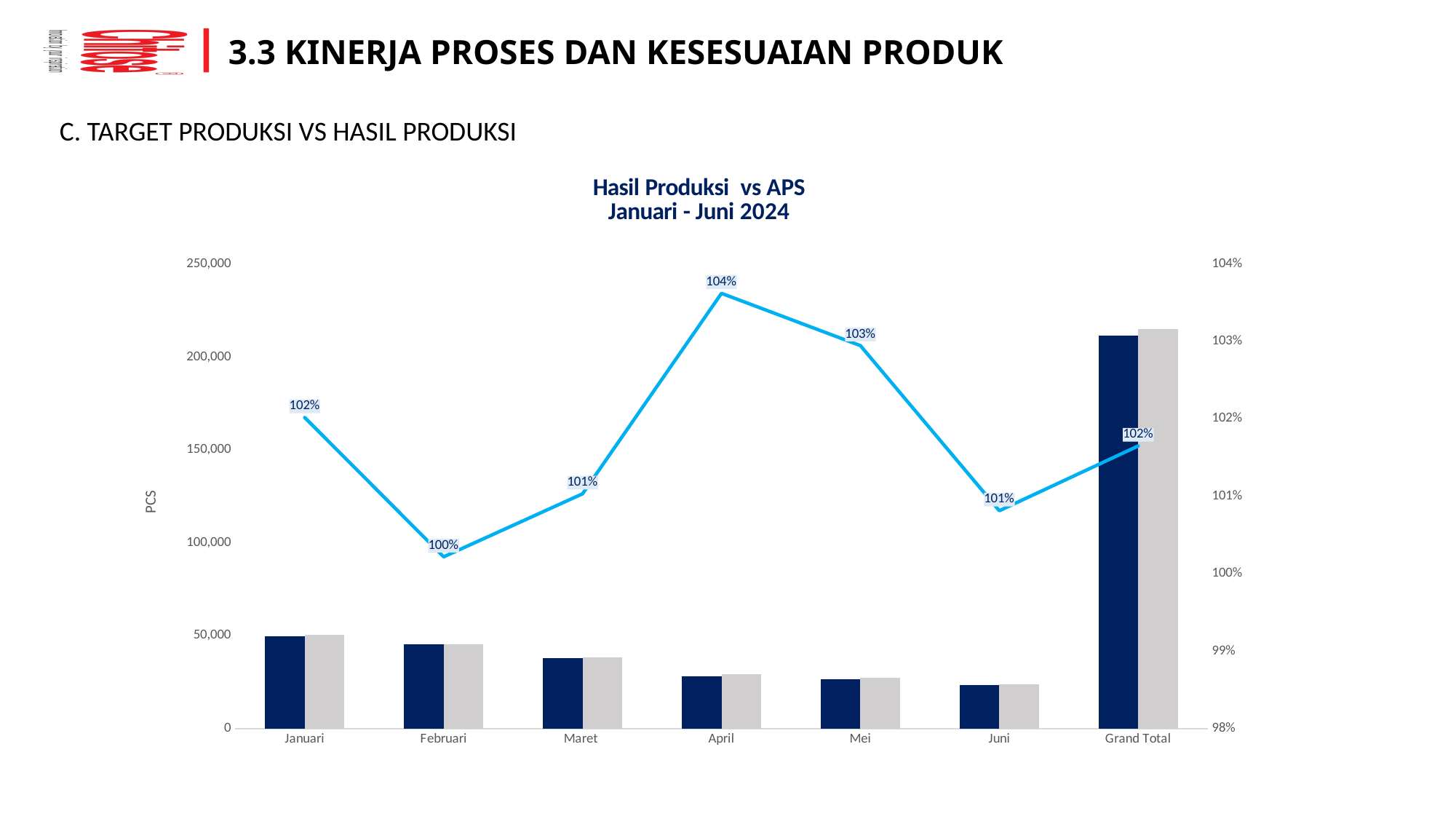
Which has a higher percentage on the line, Mei or Juni? Mei What kind of chart is this? Combination bar and line chart How many categories are shown on the x axis? 7 Is the value of the dark blue bar for Grand Total greater or less than 200,000? greater Is the value of the dark blue bar for Maret greater or less than 50,000? less What is the difference between the percentage for April and the percentage for Februari? 4 percentage points Which month has the lowest percentage on the line? Februari What is the percentage value shown for Februari on the line? 100% What is the percentage value shown for Grand Total on the line? 102% Which month has the highest percentage on the line? April What is the percentage value shown for April on the line? 104% What is the title of the chart? Hasil Produksi vs APS Januari - Juni 2024